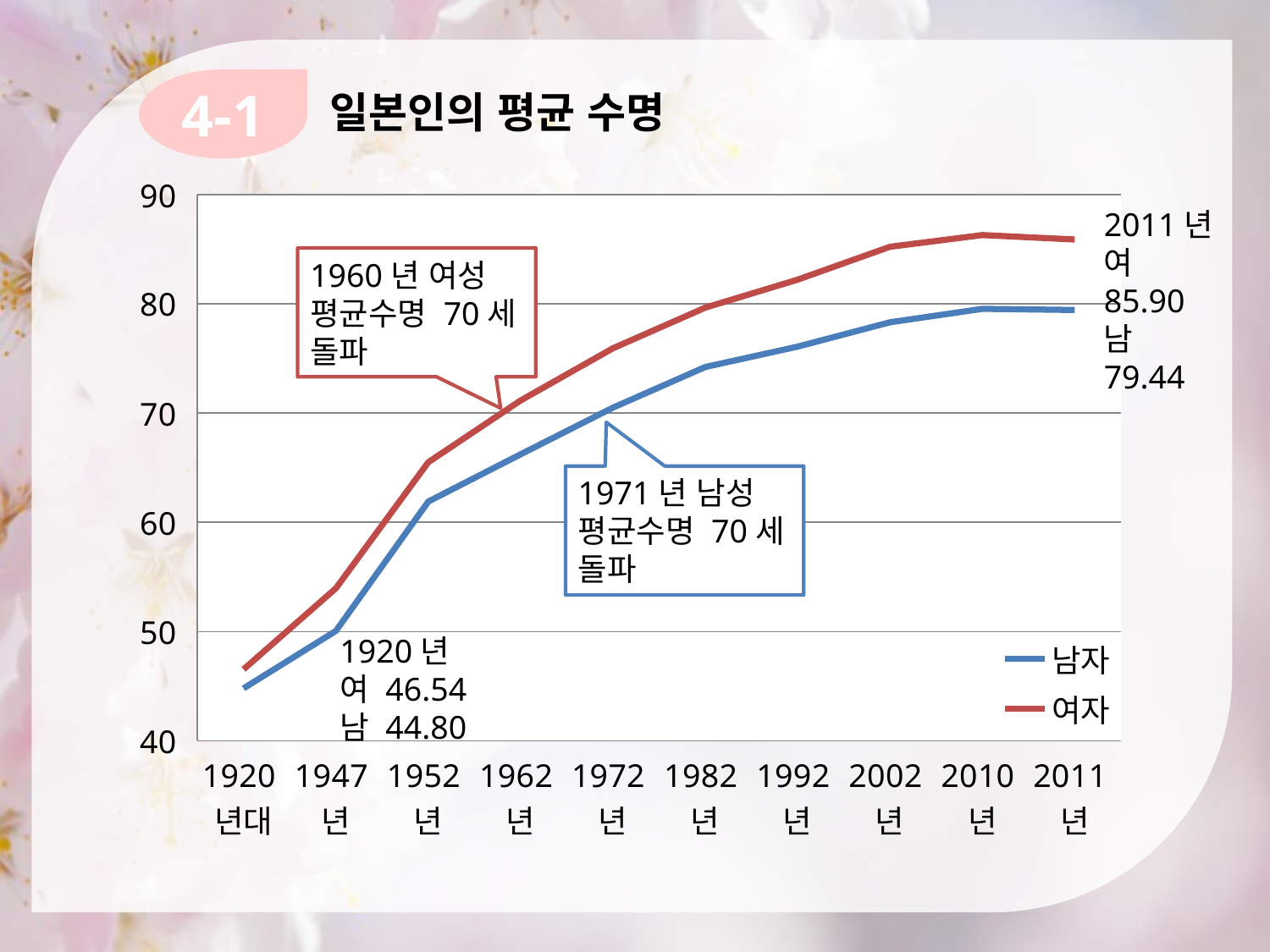
What is the title of the chart? 일본인의 평균 수명 Do the values for 남자 rise or fall from 1920년대 to 2011년? rise What is the value for 여자 in 2011년? 85.90 What is the value for 남자 in 1920년대? 44.80 What is the value for 여자 in 1920년대? 46.54 What kind of chart is shown on the slide? line chart How many series does the legend list? 2 How many year categories are shown on the x axis? 10 What is the value for 남자 in 2011년? 79.44 Is the value for 남자 in 1952년 greater or less than 70? less What is the difference between the 여자 and 남자 values in 2011년? 6.46 What is the difference between the 여자 and 남자 values in 1920년대? 1.74